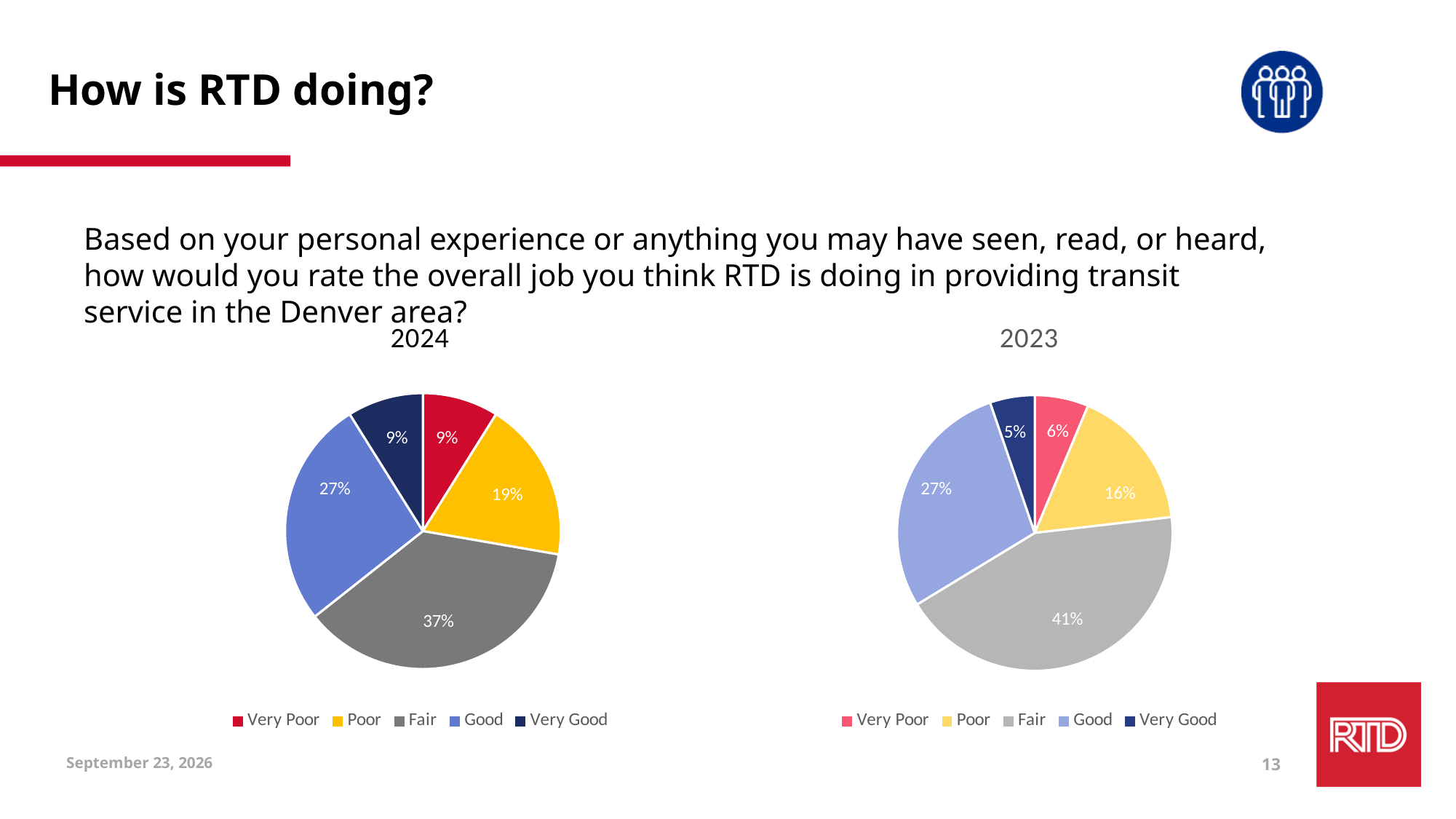
What type of chart is used to show the 2024 ratings? Pie chart In the 2024 pie chart, what percentage rated RTD as Poor? 19% In the 2024 pie chart, which rating category has the largest share? Fair In the 2023 pie chart, what share of respondents rated RTD as Fair? 41% What colour represents the Fair category in the 2024 pie chart? Grey In the 2023 pie chart, which rating category has the smallest share? Very Good In the 2024 pie chart, what is the combined share of Good and Very Good ratings? 36% In the 2023 pie chart, what percentage rated RTD as Very Good? 5% What is the difference between the Fair share in 2023 and the Fair share in 2024? 4 percentage points In the 2024 pie chart, what share of respondents rated RTD as Fair? 37% Is the Poor share larger in the 2024 chart or the 2023 chart? 2024 How many rating categories does each pie chart show? 5